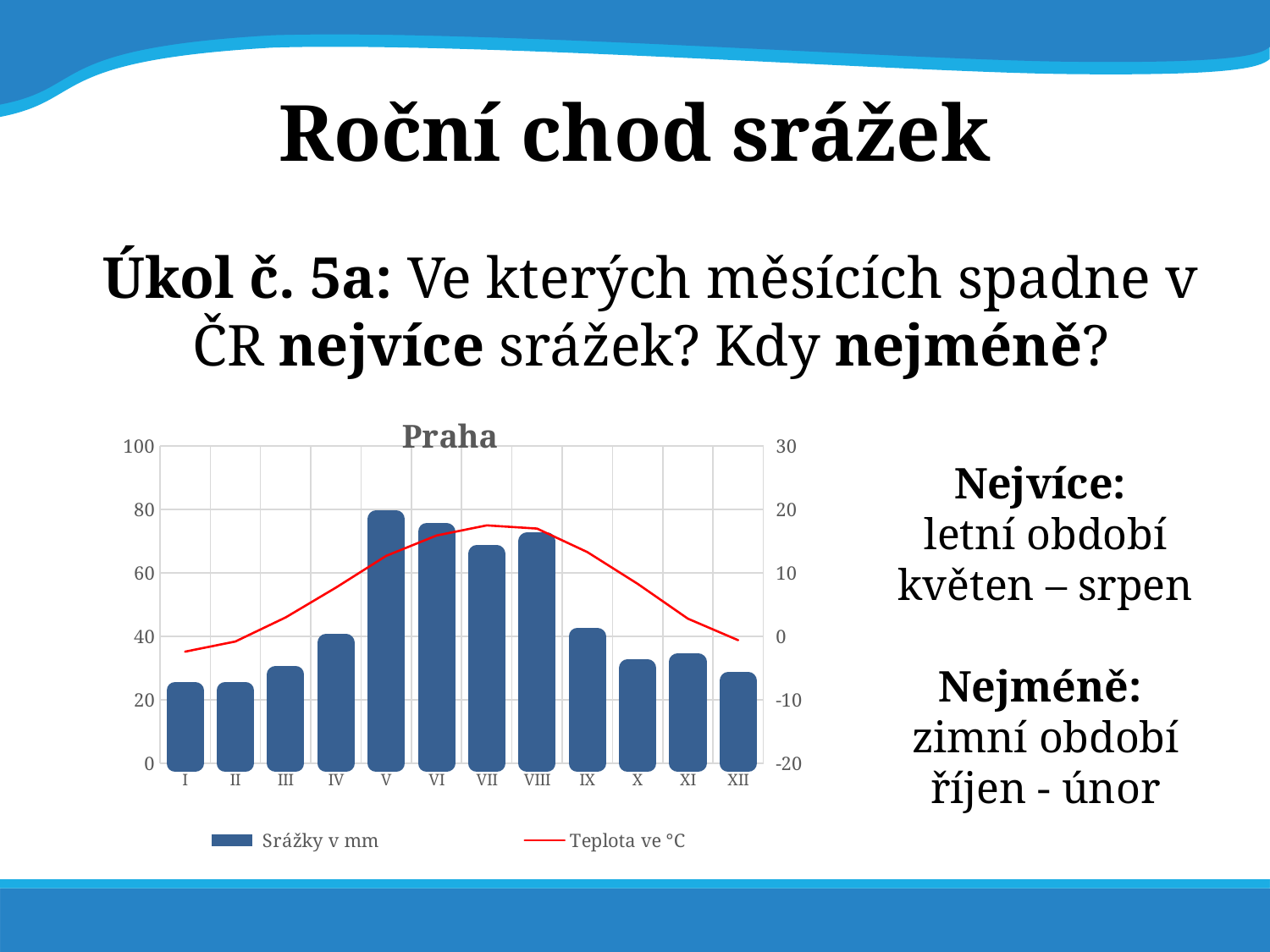
What kind of chart is shown on the slide? A bar chart combined with a line What are the two series named in the legend? Srážky v mm and Teplota ve °C Which has the larger precipitation bar, month V or month IX? V Do the precipitation bars rise or fall from month I to month V? rise Is the precipitation value for month X greater or less than 40? less Is the precipitation value for month V greater or less than 60? greater Which has the larger precipitation bar, month VIII or month III? VIII Which month has the highest precipitation (Srážky v mm) bar? V What is the title of the chart? Praha How many months (categories) are shown on the x axis? 12 How many series does the chart legend list? 2 Is the precipitation value for month IV greater or less than 60? less